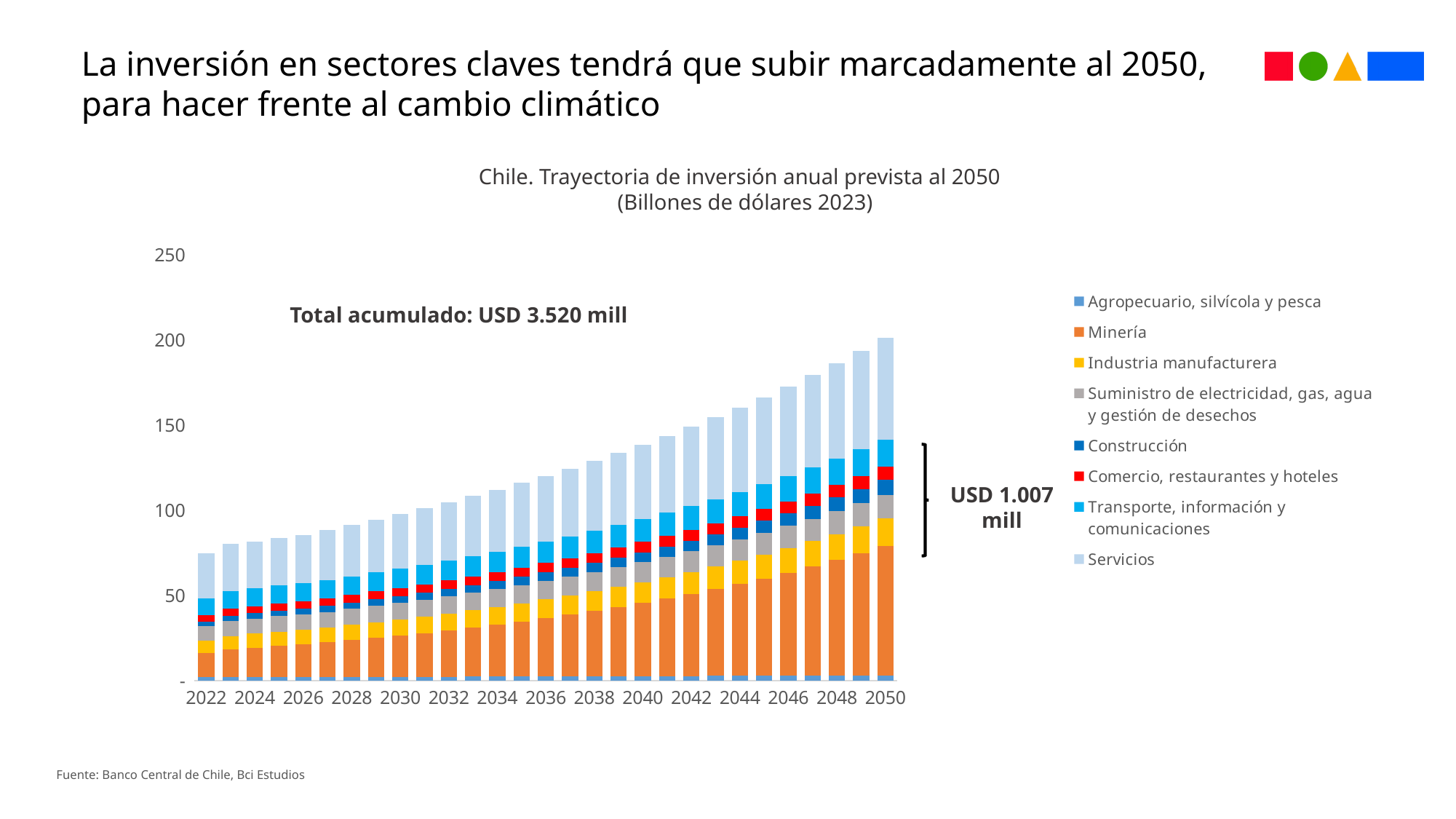
Which year has a larger total investment, 2030 or 2046? 2046 How many years (bars) are plotted on the x axis? 29 Which year has the lowest total annual investment? 2022 Which year has the highest total annual investment? 2050 Is the total value for 2022 greater or less than 100? less What is the accumulated total stated on the chart? USD 3.520 mill Is the total value for 2040 greater or less than 150? less Do the total annual investment values rise or fall from 2022 to 2050? Rise What kind of chart is shown on the slide? Stacked bar chart How many series does the legend list? 8 Which legend entry is shown in orange? Minería Is the total value for 2050 greater or less than 150? greater